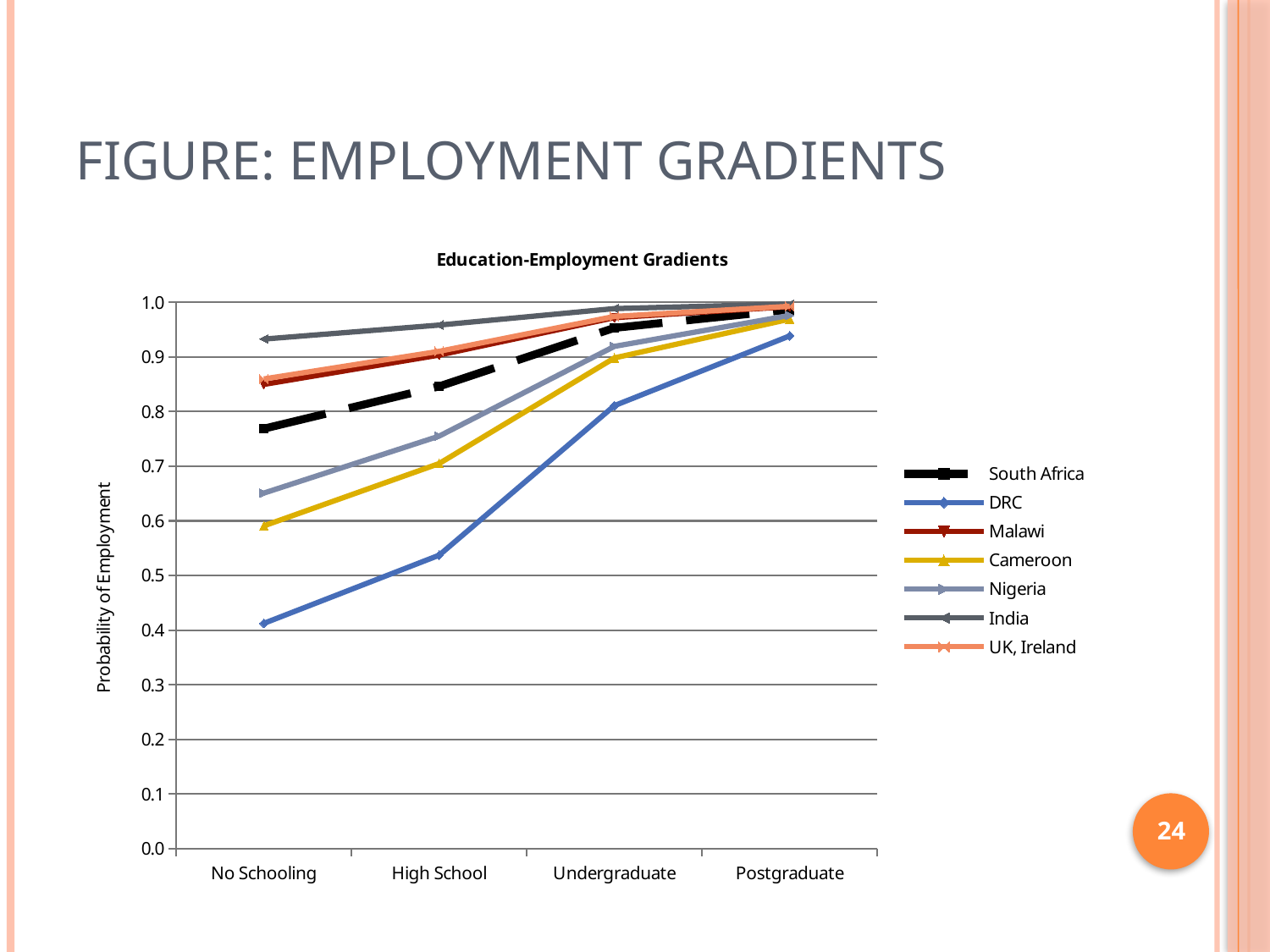
How many education categories are shown on the x axis? 4 Which country has the lowest probability of employment at No Schooling? DRC Is the value for Nigeria at No Schooling greater or less than 0.6? greater Is the value for India at No Schooling greater or less than 0.9? greater Is the value for South Africa at High School greater or less than 0.8? greater At High School, which is larger: the value for Nigeria or the value for Cameroon? Nigeria What is the title of the chart? Education-Employment Gradients What kind of chart is shown on the slide? line chart Does the DRC line rise or fall from No Schooling to Postgraduate? rise Which country has the highest probability of employment at No Schooling? India How many series does the legend list? 7